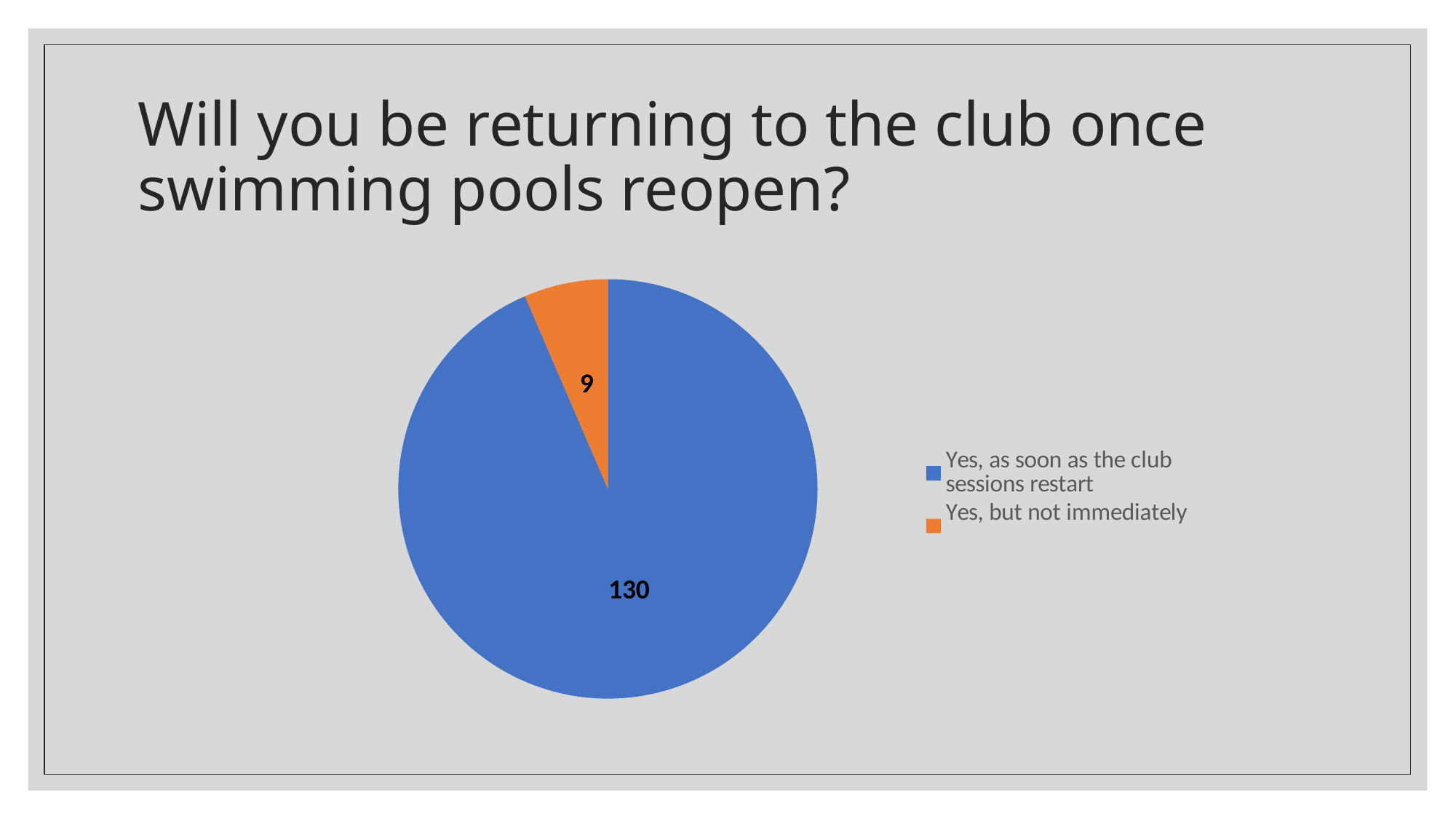
How many responses are shown for "Yes, as soon as the club sessions restart"? 130 What is the total number of responses shown in the pie chart? 139 How many categories does the pie chart show? 2 What share of the total responses does "Yes, as soon as the club sessions restart" represent, to one decimal place? 93.5% Which response category has the smallest slice of the pie? Yes, but not immediately Which response category has the largest slice of the pie? Yes, as soon as the club sessions restart What kind of chart is shown on the slide? pie chart What colour is the slice for "Yes, but not immediately"? orange How many responses are shown for "Yes, but not immediately"? 9 Which has more responses: "Yes, as soon as the club sessions restart" or "Yes, but not immediately"? Yes, as soon as the club sessions restart What is the title of the slide containing the pie chart? Will you be returning to the club once swimming pools reopen? What is the difference between the number of responses for "Yes, as soon as the club sessions restart" and "Yes, but not immediately"? 121